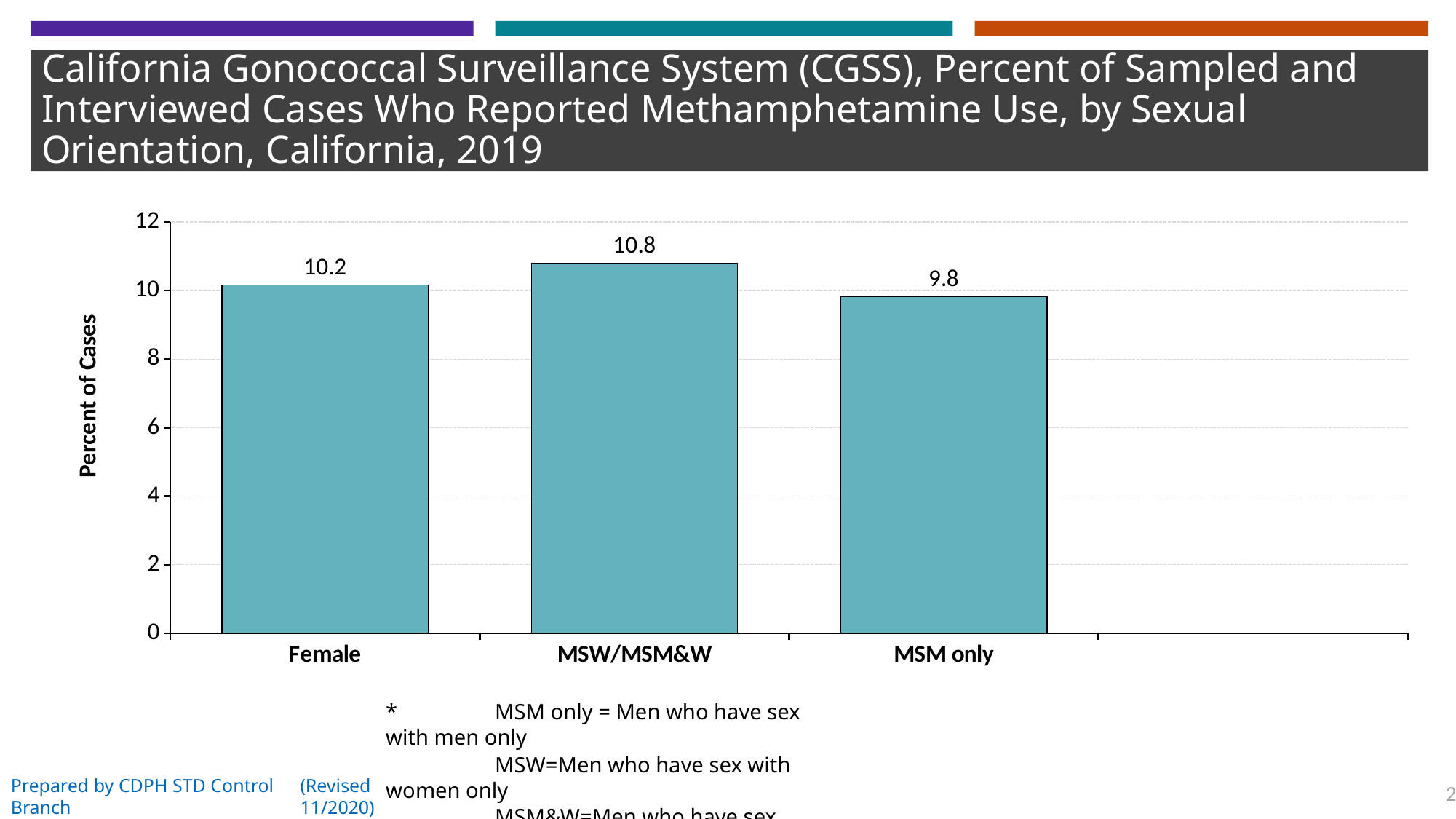
What is the percent of cases for MSM only? 9.8 Which category has the highest percent of cases? MSW/MSM&W Which is larger, the value for Female or the value for MSW/MSM&W? MSW/MSM&W Which category has the lowest percent of cases? MSM only Is the value for MSM only greater or less than 10? less What is the percent of cases for Female? 10.2 What is the difference between the values for MSW/MSM&W and MSM only? 1.0 What kind of chart is shown on the slide? bar chart What is the difference between the values for Female and MSM only? 0.4 What is the label of the y axis? Percent of Cases How many categories are shown on the x axis? 3 What is the percent of cases for MSW/MSM&W? 10.8